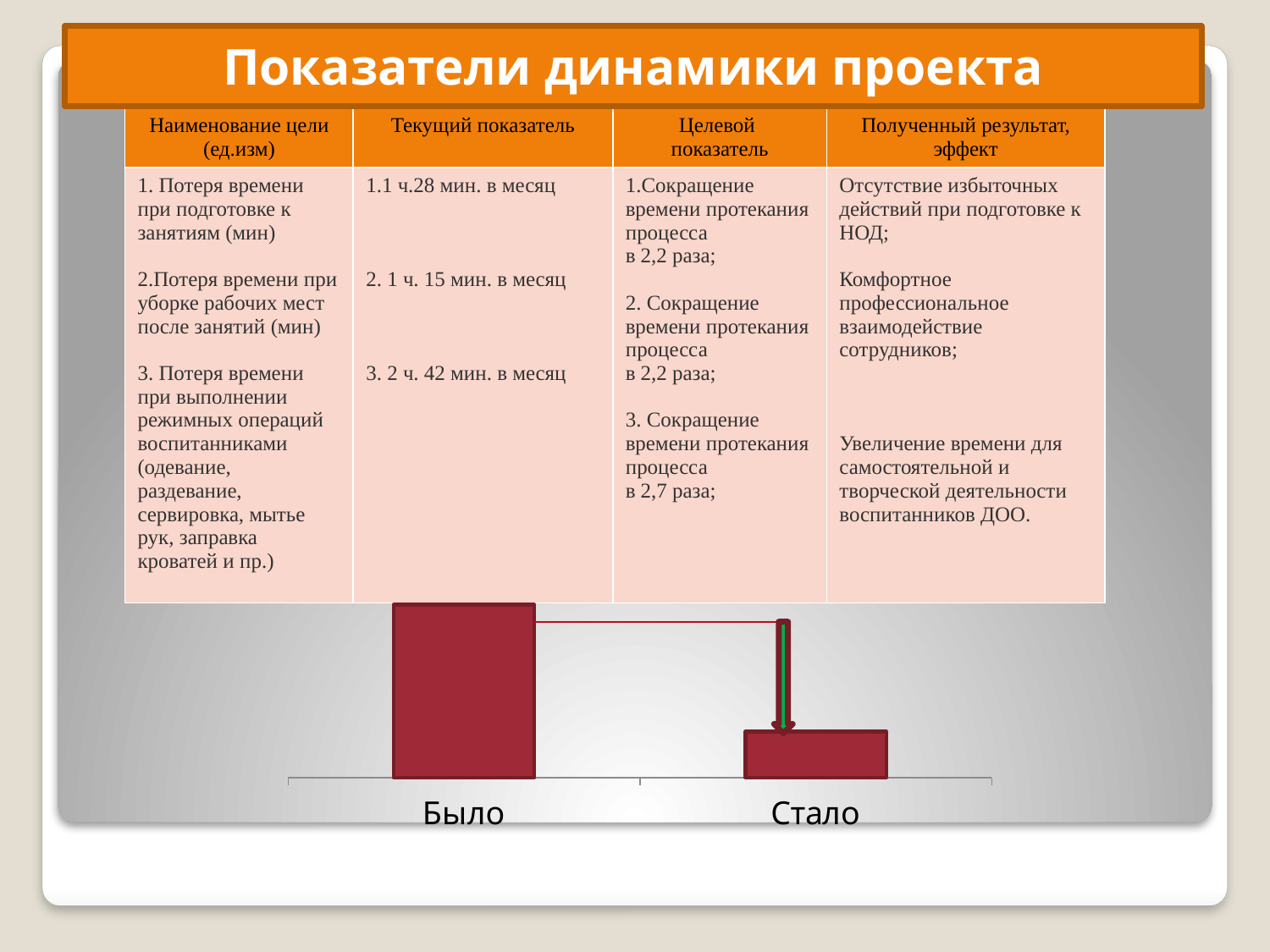
Which category in the bar chart has the lowest bar? Стало In the bar chart, is the bar for Было taller or shorter than the bar for Стало? taller Do the bar values rise or fall from Было to Стало? fall What are the two category labels on the x axis of the bar chart? Было, Стало How many bars does the chart at the bottom of the slide have? 2 What kind of chart is shown at the bottom of the slide? bar chart What colour are the bars in the chart? dark red Which category in the bar chart has the highest bar? Было